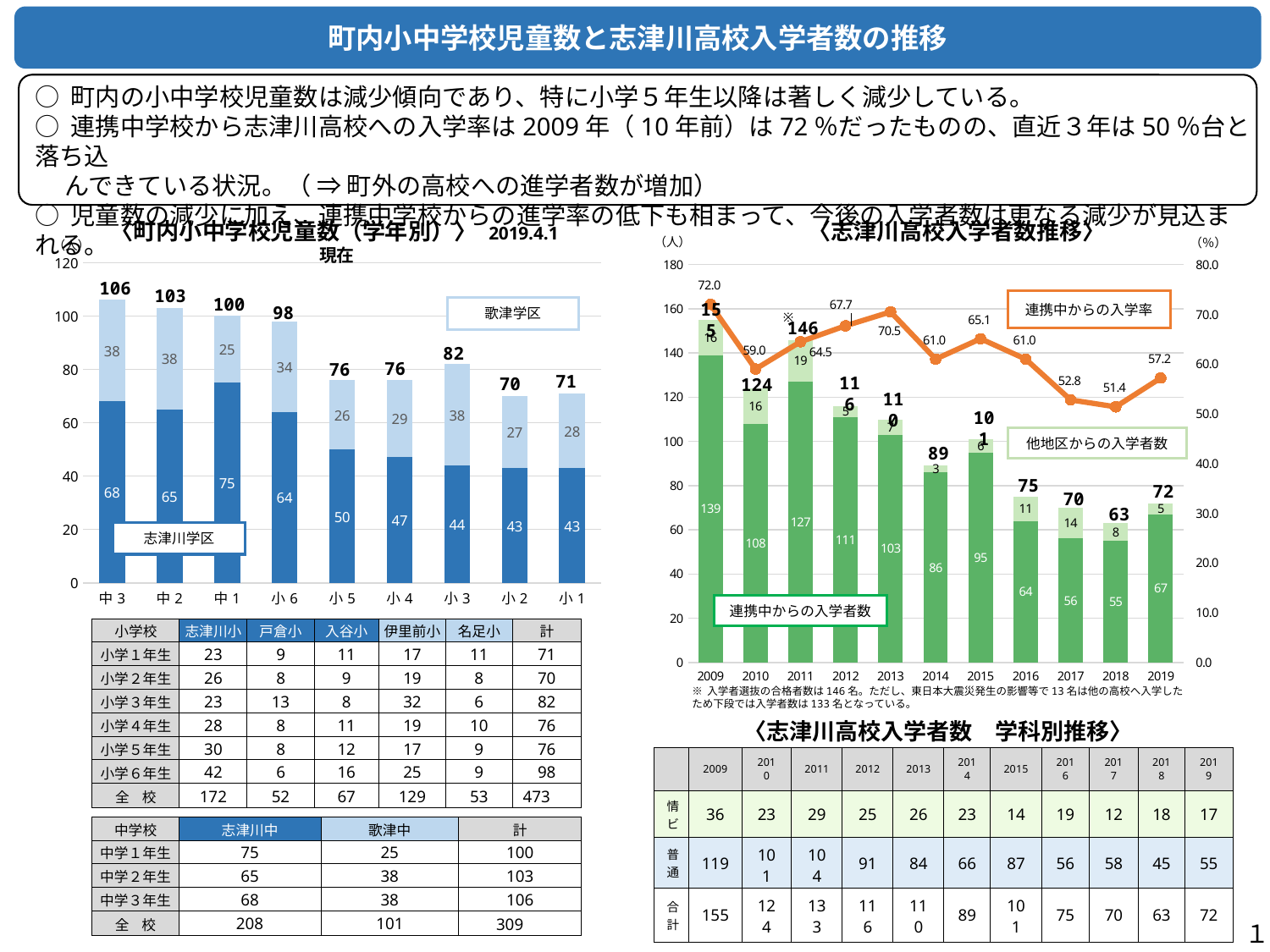
In the 〈町内小中学校児童数（学年別）〉 chart on the left, what is the total number of children for 中3? 106 In the 〈町内小中学校児童数（学年別）〉 chart on the left, what is the 歌津学区 value for 中1? 25 In the 〈志津川高校入学者数推移〉 chart on the right, what is the 他地区からの入学者数 for 2017? 14 In the 〈町内小中学校児童数（学年別）〉 chart on the left, what is the difference between the totals for 中3 and 小1? 35 In the 〈志津川高校入学者数推移〉 chart on the right, what is the 連携中からの入学者数 for 2015? 95 In the 〈町内小中学校児童数（学年別）〉 chart on the left, which grade has the lowest total number of children? 小2 In the 〈志津川高校入学者数推移〉 chart on the right, what is the 連携中からの入学率 for 2009? 72.0 In the 〈志津川高校入学者数推移〉 chart on the right, which year has the lowest total number of entrants? 2018 In the 〈志津川高校入学者数推移〉 chart on the right, is the 連携中からの入学率 for 2018 higher or lower than for 2019? lower In the 〈町内小中学校児童数（学年別）〉 chart on the left, what is the 志津川学区 value for 小5? 50 In the 〈町内小中学校児童数（学年別）〉 chart on the left, how many grade categories are shown on the x axis? 9 What type of chart is the 〈志津川高校入学者数推移〉 chart on the right? Stacked bar chart with a line